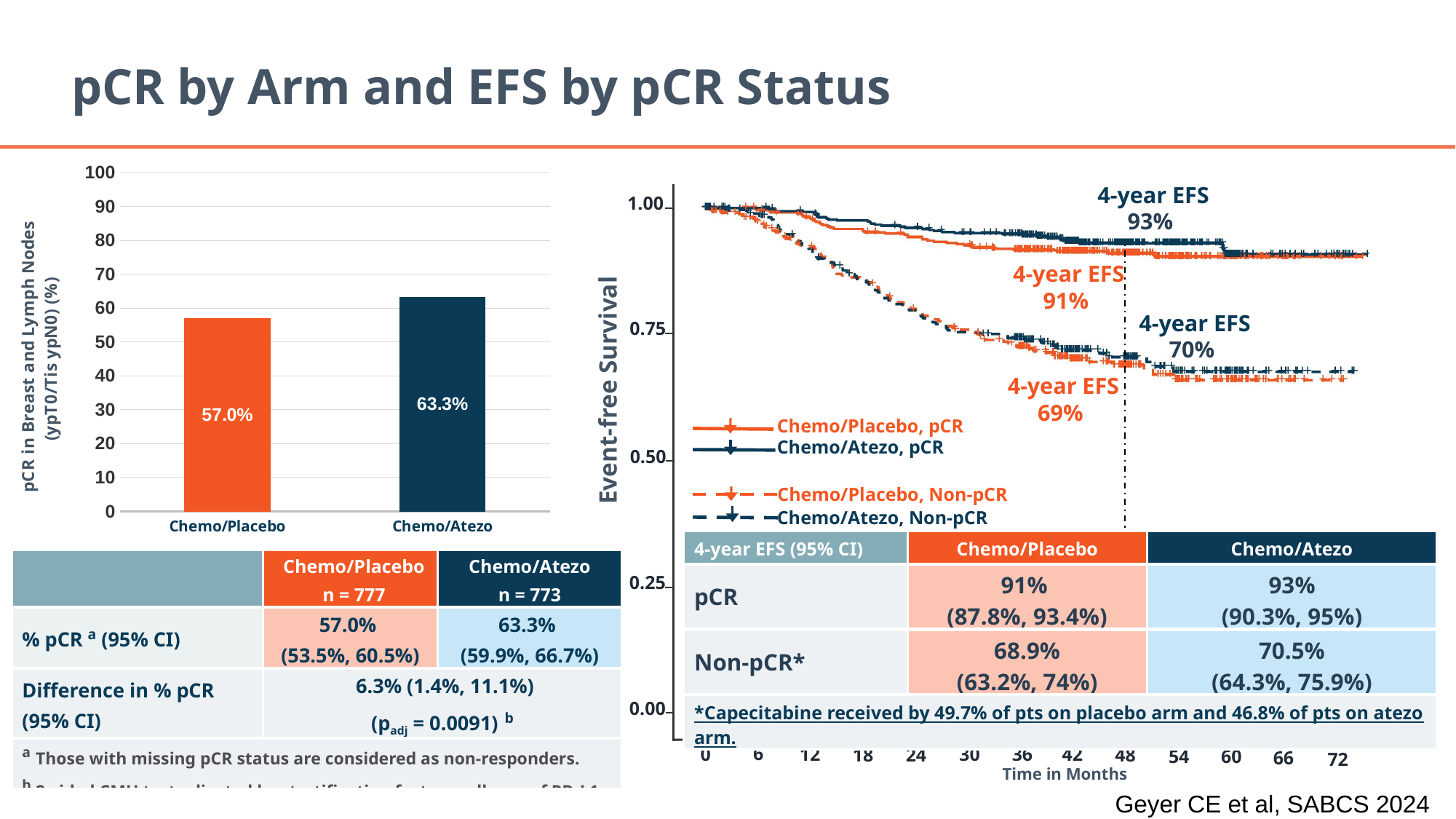
In the Event-free Survival chart on the right, what is the 4-year EFS for the Chemo/Atezo, pCR group? 93% In the bar chart on the left, which arm has the higher pCR rate? Chemo/Atezo In the Event-free Survival chart on the right, which group has the lowest 4-year EFS? Chemo/Placebo, Non-pCR In the bar chart on the left, what is the pCR rate for the Chemo/Placebo arm? 57.0% How many bars are shown in the bar chart on the left? 2 In the bar chart on the left, is the value for Chemo/Placebo greater or less than 60? less What type of chart is the chart on the left of the slide? Bar chart How many series does the legend of the Event-free Survival chart on the right list? 4 In the Event-free Survival chart on the right, what is the 4-year EFS for the Chemo/Placebo, Non-pCR group? 69% In the bar chart on the left, what is the difference in pCR rate between Chemo/Atezo and Chemo/Placebo? 6.3% In the Event-free Survival chart on the right, do the survival curves rise or fall as time in months increases? Fall In the bar chart on the left, what is the pCR rate for the Chemo/Atezo arm? 63.3%